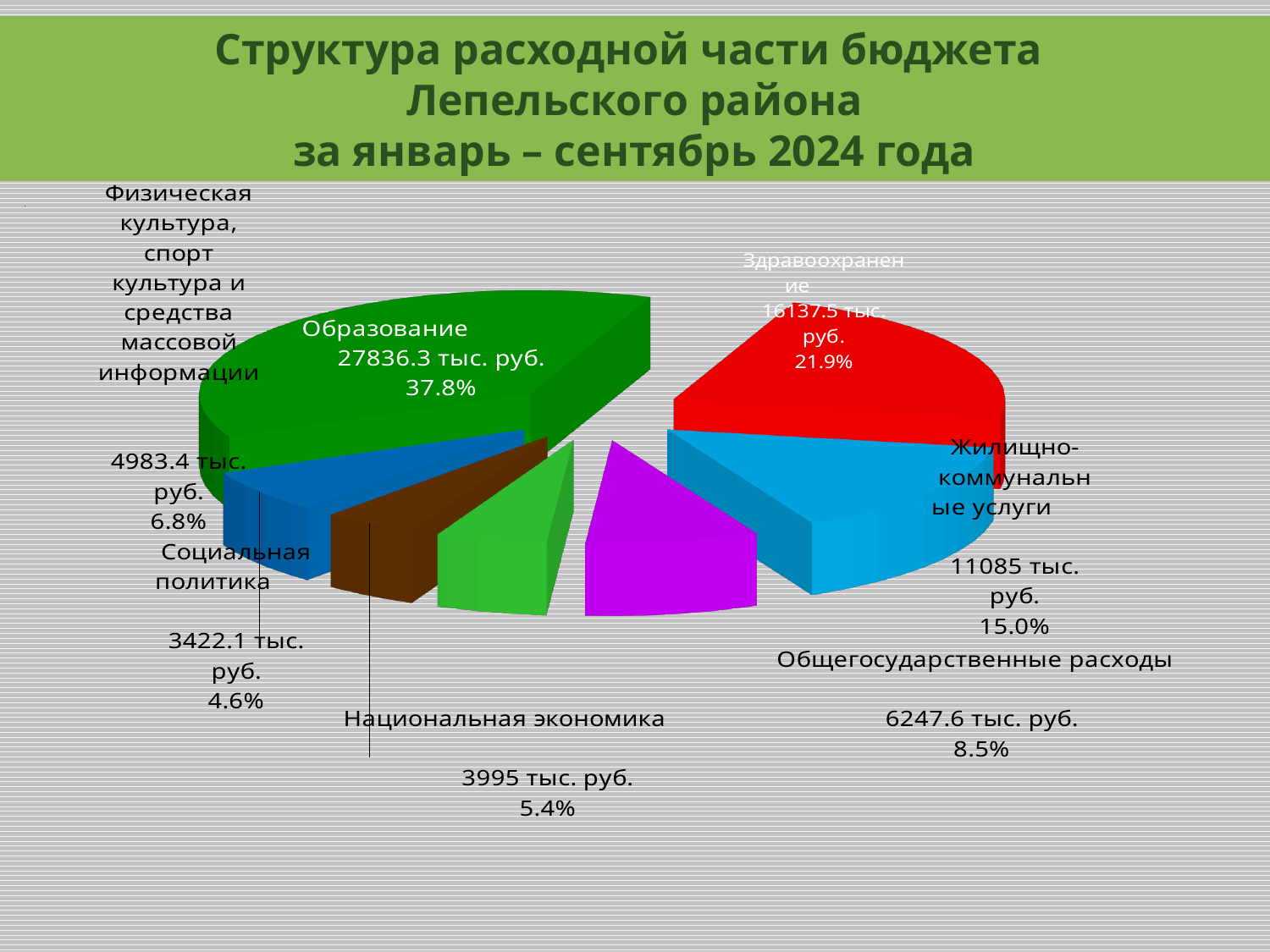
What period does the chart title say the budget expenditure structure covers? январь – сентябрь 2024 года Which expenditure category has the smallest share of the budget? Социальная политика What is the difference in percentage points between the shares of Образование and Здравоохранение? 15.9 What kind of chart is shown on the slide? Pie chart What is the amount shown for Образование? 27836.3 тыс. руб. Which expenditure category has the largest share of the budget? Образование What is the amount shown for Национальная экономика? 3995 тыс. руб. What share of the budget is Общегосударственные расходы? 8.5% How many slices (expenditure categories) does the pie chart have? 7 Which is larger: the share for Физическая культура, спорт, культура и средства массовой информации or the share for Национальная экономика? Физическая культура, спорт, культура и средства массовой информации What is the amount shown for Жилищно-коммунальные услуги? 11085 тыс. руб. What percentage of the budget goes to Здравоохранение? 21.9%